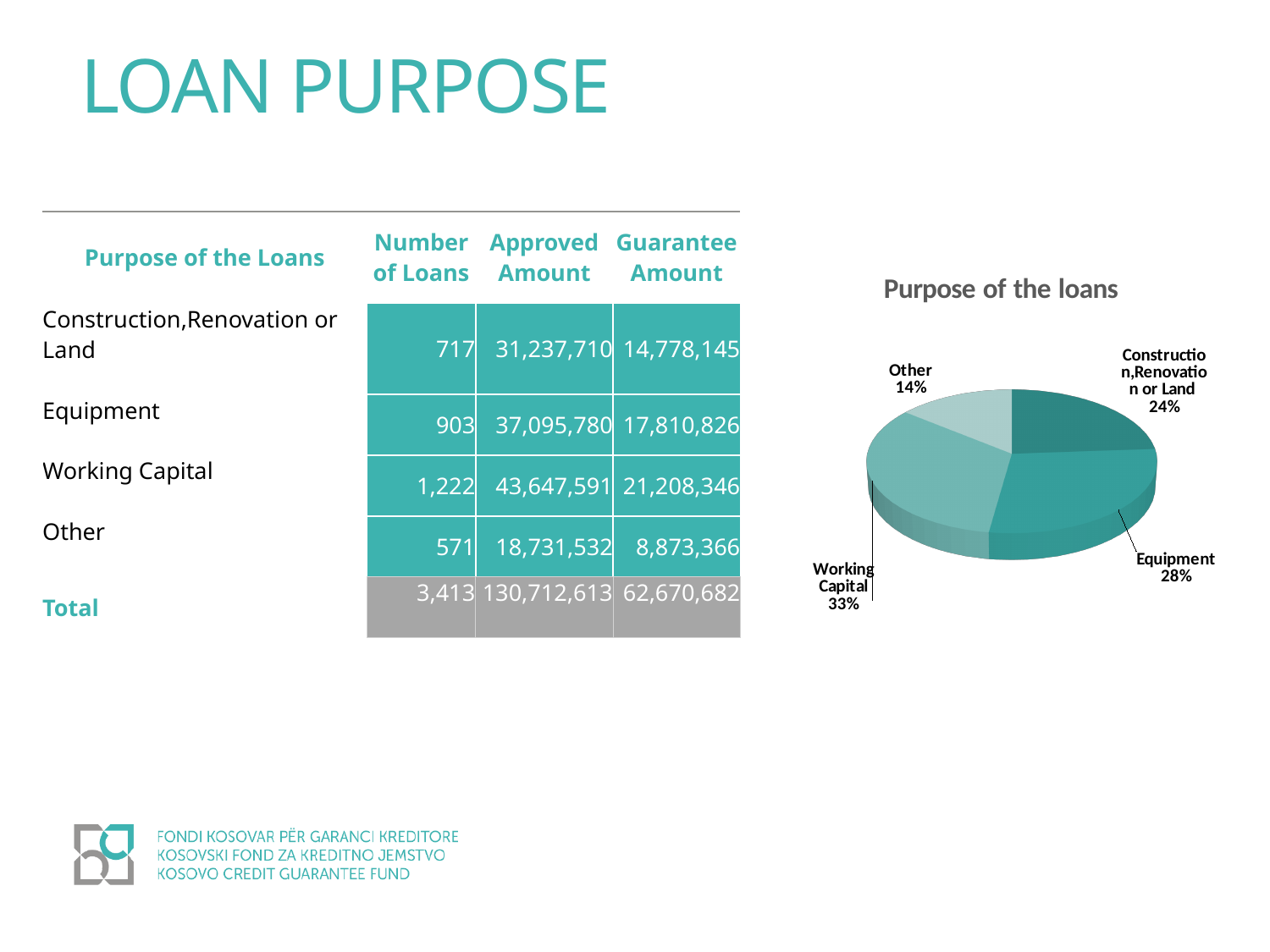
Which slice is larger, Equipment or Construction,Renovation or Land? Equipment What percentage does the Construction,Renovation or Land slice show? 24% Which loan purpose has the largest slice in the pie chart? Working Capital What percentage of the pie chart is Equipment? 28% Which loan purpose has the smallest slice in the pie chart? Other What share of the pie chart does Working Capital represent? 33% What is the title of the chart on the slide? Purpose of the loans By how many percentage points does the Working Capital slice exceed the Equipment slice? 5 What share of the pie chart is labelled Other? 14% How many slices does the pie chart have? 4 What type of chart is shown on the slide? Pie chart What is the difference in percentage points between the Construction,Renovation or Land slice and the Other slice? 10